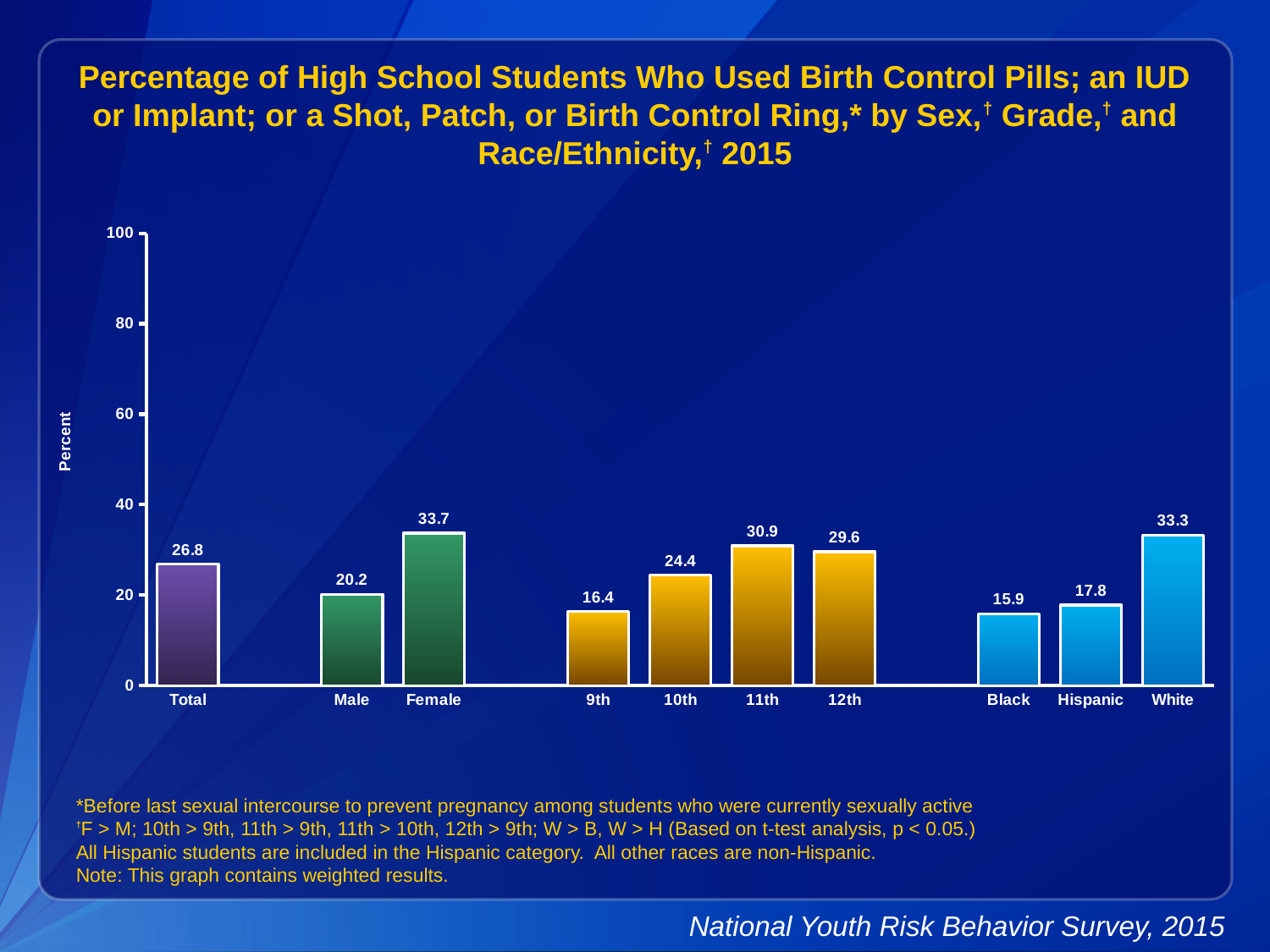
What is the value for Female? 33.7 Which is larger, the value for 12th grade or the value for 10th grade? 12th What kind of chart is shown on the slide? bar chart What is the value for Hispanic? 17.8 Which category has the lowest value? Black What is the value for Total? 26.8 Do the values rise or fall from 9th grade to 11th grade? rise Which category has the highest value? Female What is the difference between the Female and Male values? 13.5 What is the value for 11th grade? 30.9 How many categories are shown on the x axis? 10 Is the value for White greater or less than 20? greater